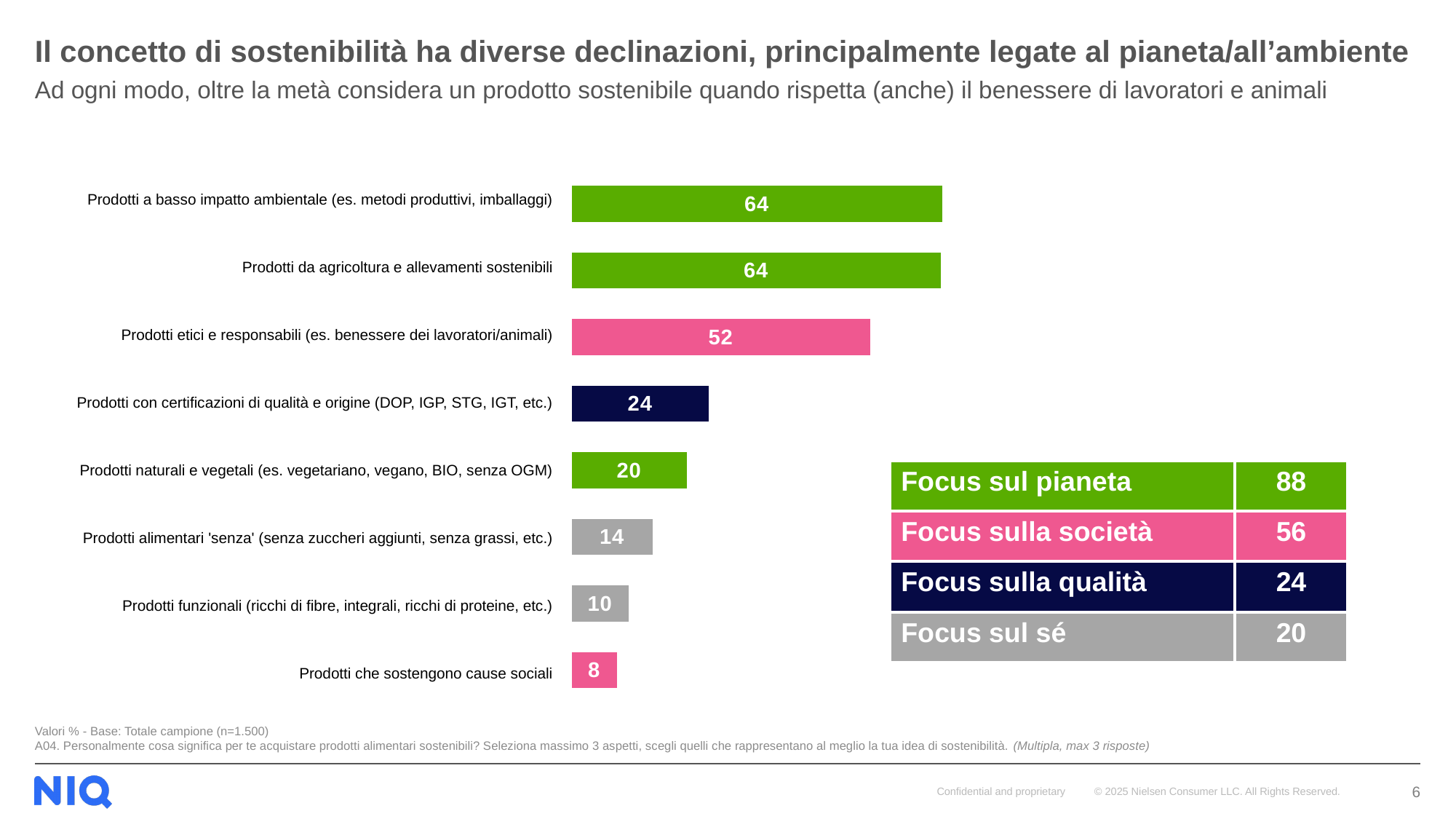
What is the difference between the values for 'Prodotti da agricoltura e allevamenti sostenibili' and 'Prodotti etici e responsabili (es. benessere dei lavoratori/animali)'? 12 What colour is the bar for 'Prodotti etici e responsabili (es. benessere dei lavoratori/animali)'? Pink What is the value for 'Prodotti alimentari 'senza' (senza zuccheri aggiunti, senza grassi, etc.)'? 14 What is the value for 'Prodotti con certificazioni di qualità e origine (DOP, IGP, STG, IGT, etc.)'? 24 What is the difference between the values for 'Prodotti naturali e vegetali (es. vegetariano, vegano, BIO, senza OGM)' and 'Prodotti che sostengono cause sociali'? 12 How many categories does the bar chart show? 8 What is the value for 'Prodotti etici e responsabili (es. benessere dei lavoratori/animali)'? 52 What is the value for 'Prodotti funzionali (ricchi di fibre, integrali, ricchi di proteine, etc.)'? 10 What kind of chart is shown on the slide? Bar chart Which is larger: the value for 'Prodotti con certificazioni di qualità e origine (DOP, IGP, STG, IGT, etc.)' or the value for 'Prodotti naturali e vegetali (es. vegetariano, vegano, BIO, senza OGM)'? Prodotti con certificazioni di qualità e origine (DOP, IGP, STG, IGT, etc.) What is the value for 'Prodotti a basso impatto ambientale (es. metodi produttivi, imballaggi)'? 64 Which category has the lowest value? Prodotti che sostengono cause sociali